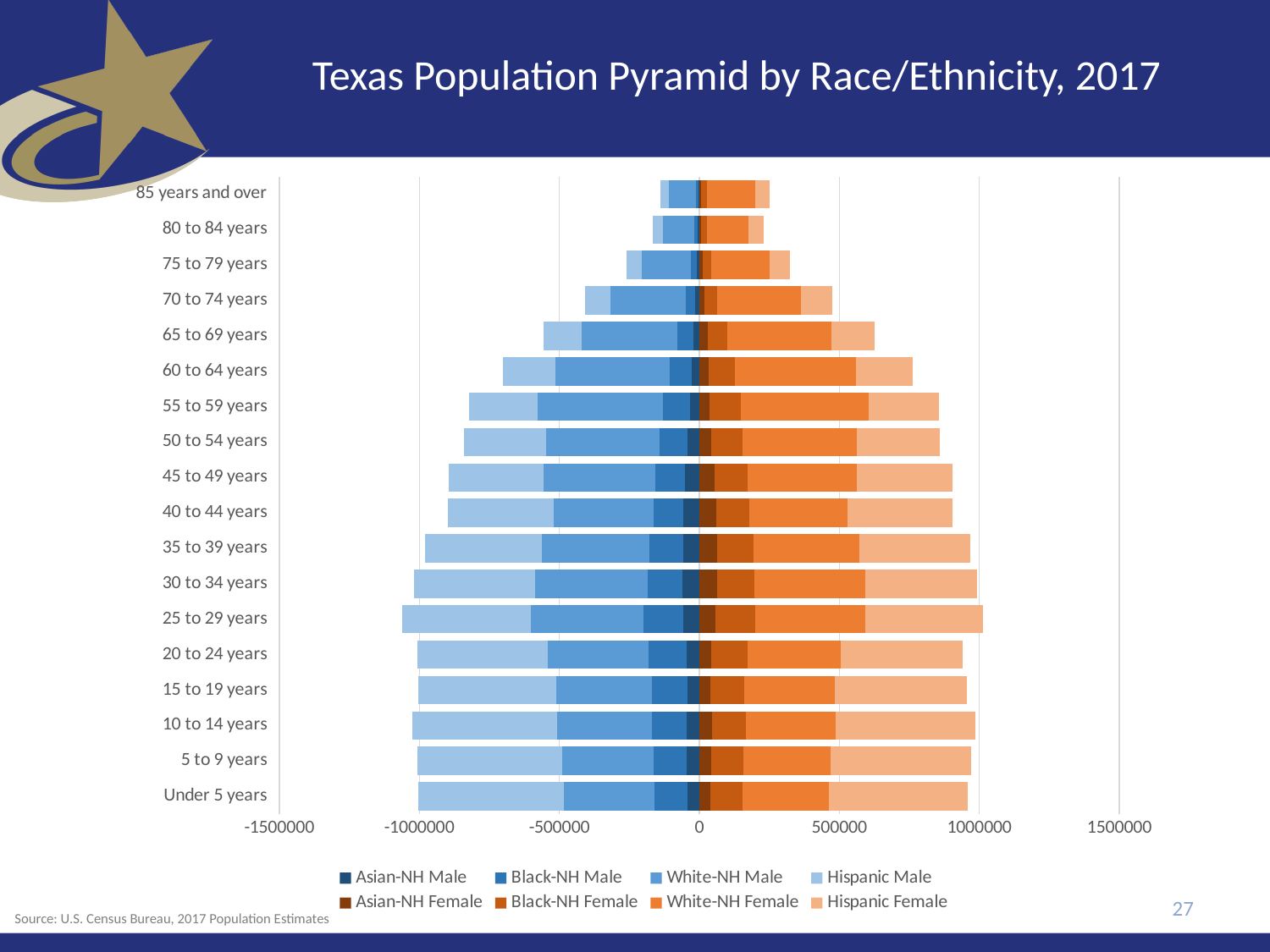
Which age group has a longer female bar, 65 to 69 years or 70 to 74 years? 65 to 69 years Moving from 30 to 34 years up to 85 years and over, do the bars get longer or shorter? Shorter How many age groups are shown on the vertical axis of the chart? 18 What source is cited for the chart data? U.S. Census Bureau, 2017 Population Estimates Which age group has the longest female (right-side) bar? 25 to 29 years What kind of chart is shown on the slide? Bar chart (stacked horizontal bar / population pyramid) How many series does the legend list? 8 What is the title of the chart? Texas Population Pyramid by Race/Ethnicity, 2017 Is the total female value for 85 years and over greater or less than 500000? less Does the male bar for 25 to 29 years extend beyond -1000000 on the axis? Yes Is the total female value for 30 to 34 years greater or less than 500000? greater